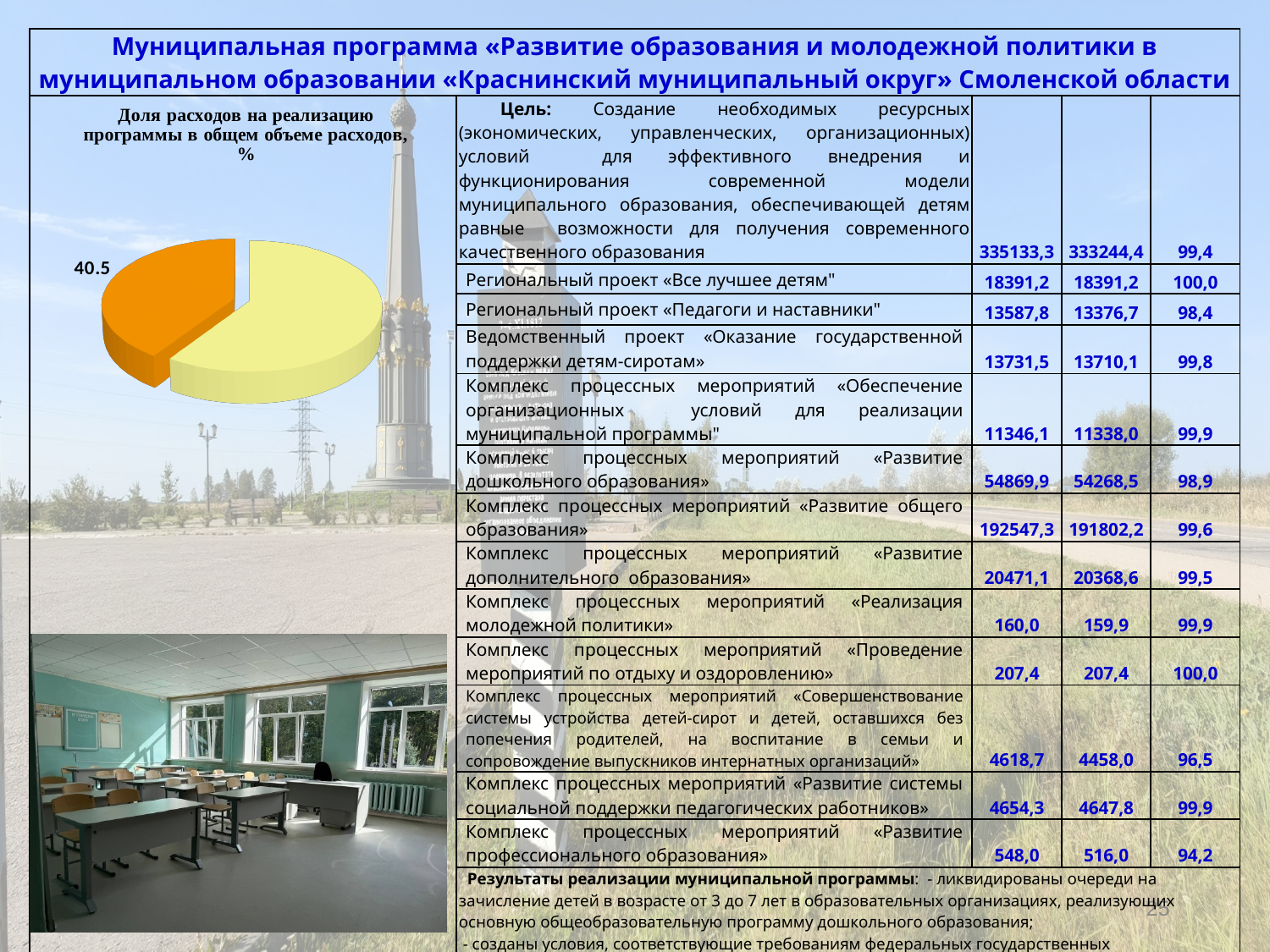
Which slice of the pie chart is larger, the orange one or the yellow one? yellow What value is printed on the orange slice of the pie chart? 40.5 How many slices does the pie chart have? 2 What share of the pie does the orange slice represent? 40.5% What kind of chart is shown on the left of the slide? pie chart What is the title of the pie chart? Доля расходов на реализацию программы в общем объеме расходов, % What colour is the slice of the pie chart that carries the data label? orange